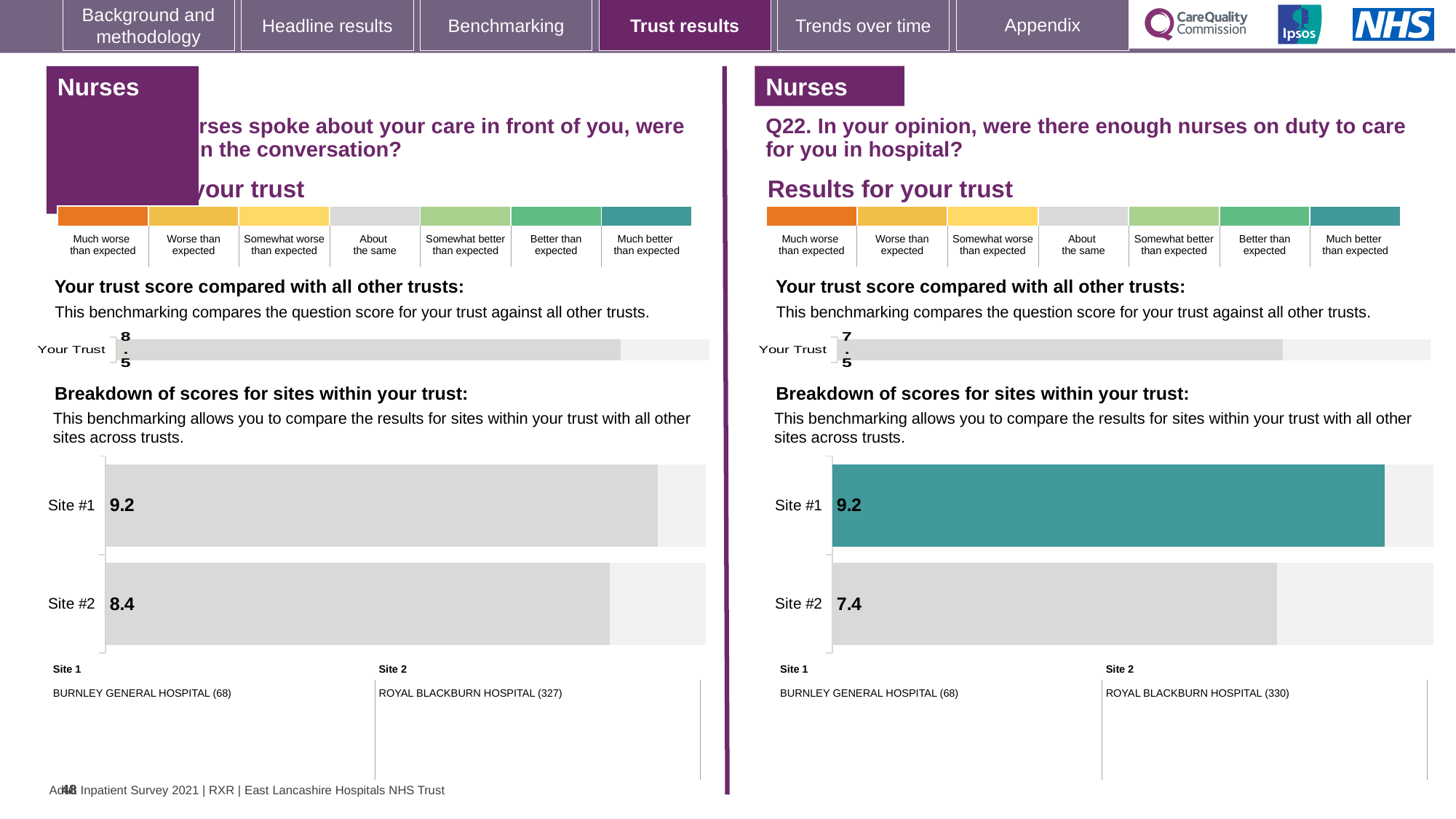
On the right-hand (Q22) site breakdown chart, what is the score for Site #1? 9.2 On the left-hand site breakdown chart, what is the difference between the Site #1 and Site #2 scores? 0.8 How many sites are shown on the left-hand site breakdown chart? 2 On the left-hand 'Your Trust' chart, what is the trust score? 8.5 On the right-hand (Q22) site breakdown chart, which site's bar is coloured teal rather than grey? Site #1 On the right-hand (Q22) site breakdown chart, what is the difference between the Site #1 and Site #2 scores? 1.8 On the left-hand site breakdown chart, what is the score for Site #1? 9.2 On the right-hand (Q22) 'Your Trust' chart, what is the trust score? 7.5 On the right-hand (Q22) site breakdown chart, which site has the higher score? Site #1 On the right-hand (Q22) site breakdown chart, what is the score for Site #2? 7.4 What type of chart is used for the site breakdown on the right-hand (Q22) side? Bar chart On the left-hand site breakdown chart, what is the score for Site #2? 8.4